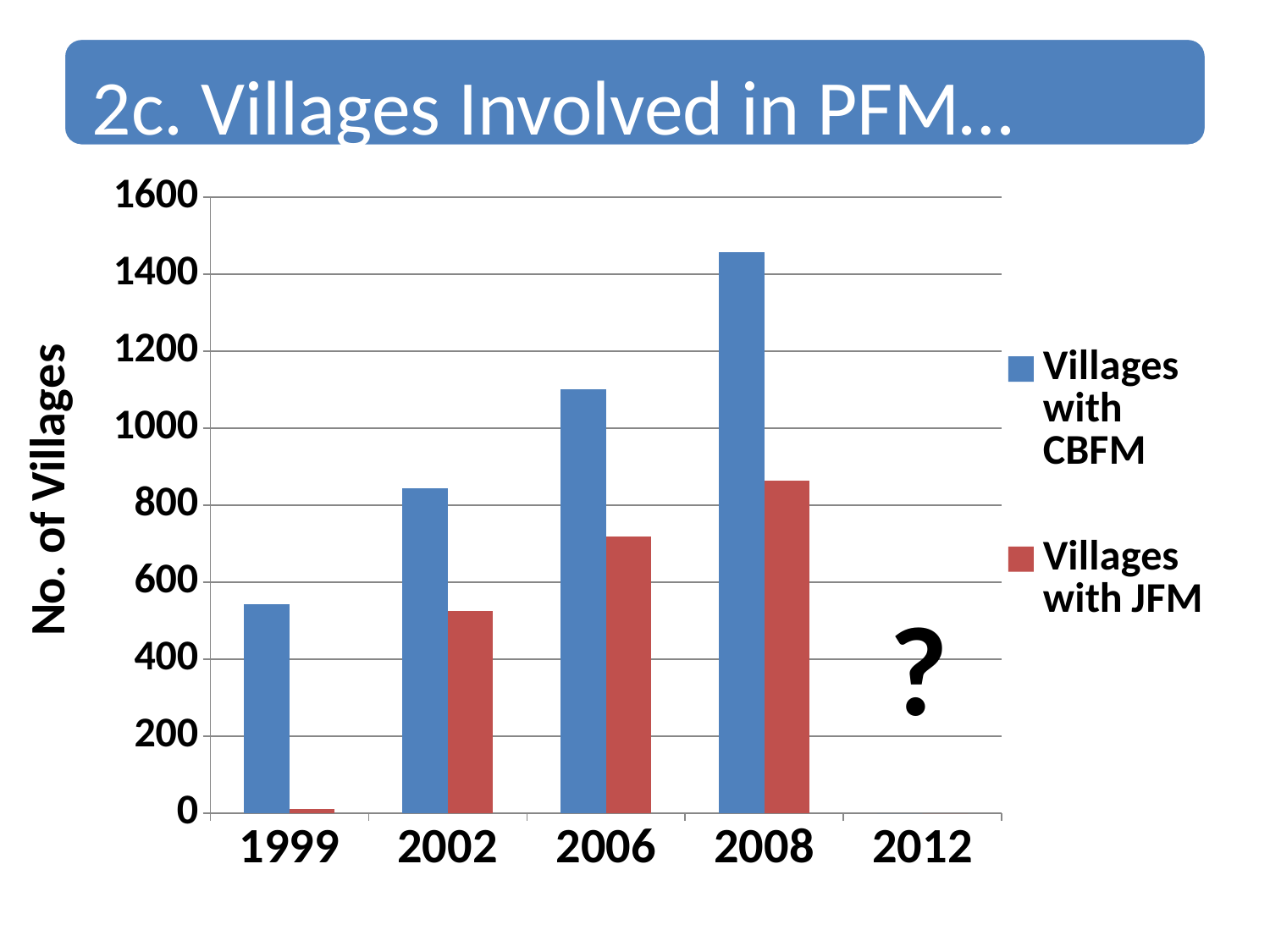
What is the label on the vertical axis? No. of Villages Is the value for Villages with JFM in 1999 greater or less than 200? less Do the values for Villages with CBFM rise or fall from 1999 to 2008? rise Is the value for Villages with CBFM in 2006 greater or less than 1000? greater In which year is the number of Villages with JFM lowest? 1999 Is the value for Villages with JFM in 2002 greater or less than 600? less What kind of chart is shown on the slide? bar chart In which year is the number of Villages with CBFM highest? 2008 How many series does the legend list? 2 In 2006, which is larger: Villages with CBFM or Villages with JFM? Villages with CBFM How many years are labelled on the x axis? 5